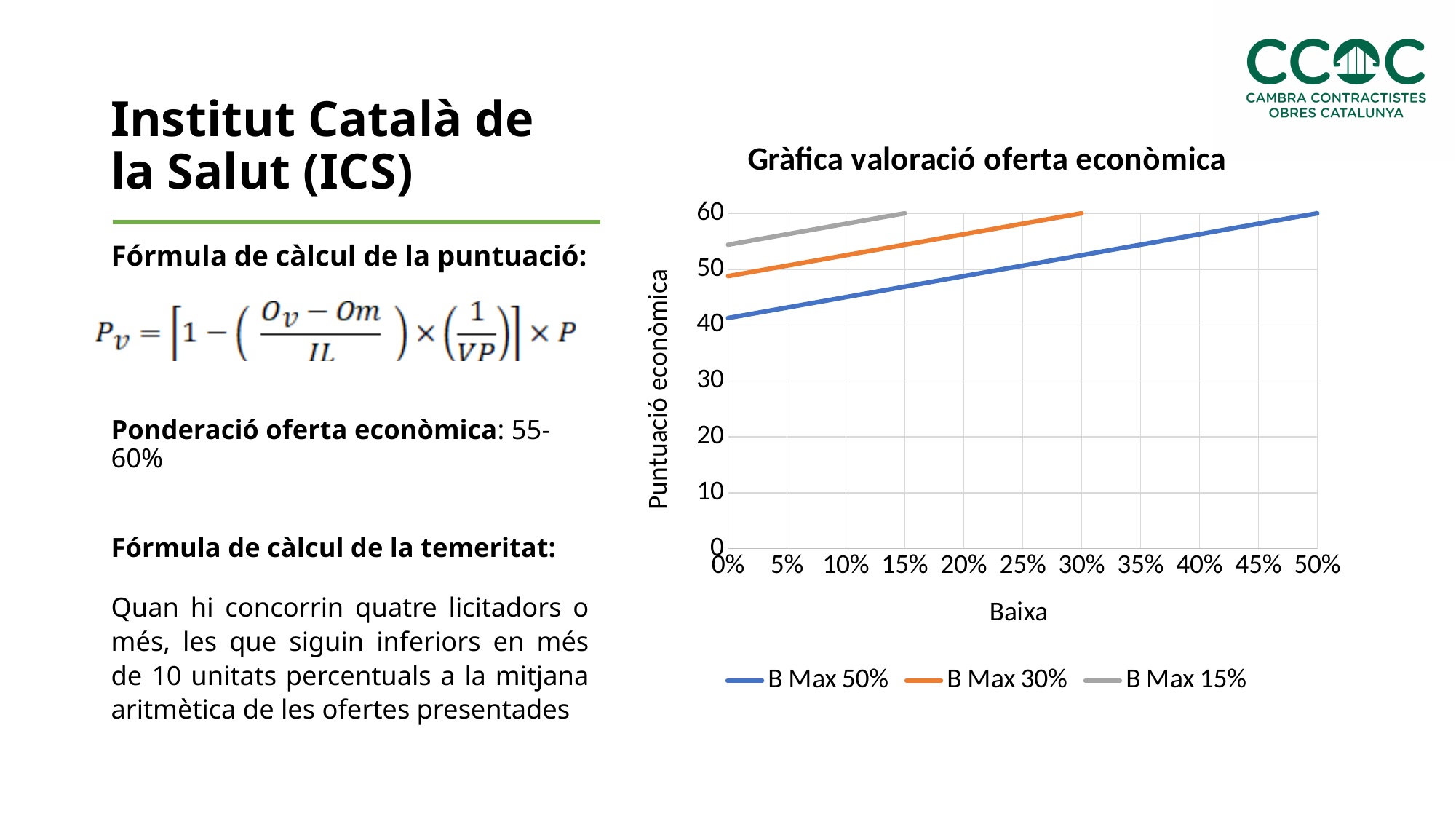
At a Baixa of 0%, which series has the higher value, B Max 15% or B Max 50%? B Max 15% What kind of chart is shown on the slide? line chart What is the label of the x axis of the chart? Baixa What value does the B Max 30% series reach at a Baixa of 30%? 60 Do the values of the B Max 50% series rise or fall as Baixa increases? rise What value does the B Max 50% series reach at a Baixa of 50%? 60 Is the value of the B Max 50% series at a Baixa of 0% greater or less than 50? less Is the value of the B Max 30% series at a Baixa of 0% greater or less than 40? greater Is the value of the B Max 15% series at a Baixa of 0% greater or less than 50? greater How many series does the legend of the chart list? 3 Which series has the lowest value at a Baixa of 0%? B Max 50% What is the title of the chart? Gràfica valoració oferta econòmica